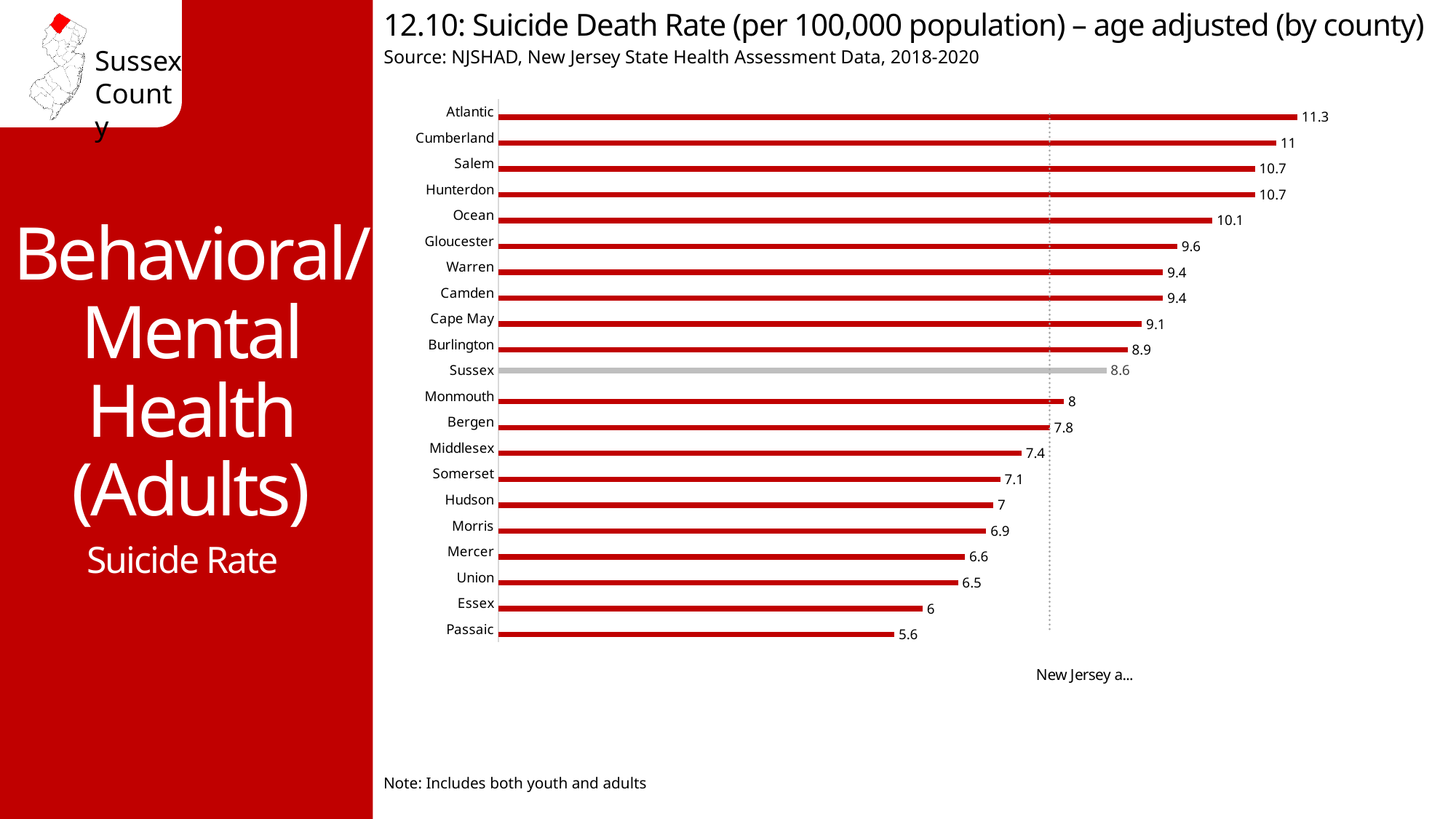
What is the suicide death rate for Sussex county? 8.6 Which county has the highest suicide death rate? Atlantic What is the difference between the suicide death rates of Sussex and Monmouth counties? 0.6 What is the suicide death rate for Atlantic county? 11.3 Which county has a higher suicide death rate, Bergen or Sussex? Sussex Which county has a higher suicide death rate, Ocean or Gloucester? Ocean What is the suicide death rate for Passaic county? 5.6 What is the difference between the suicide death rates of Atlantic and Passaic counties? 5.7 Which county has the lowest suicide death rate? Passaic Which county's bar is shown in grey rather than red? Sussex How many counties are shown in the chart? 21 What type of chart is shown on the slide? Bar chart